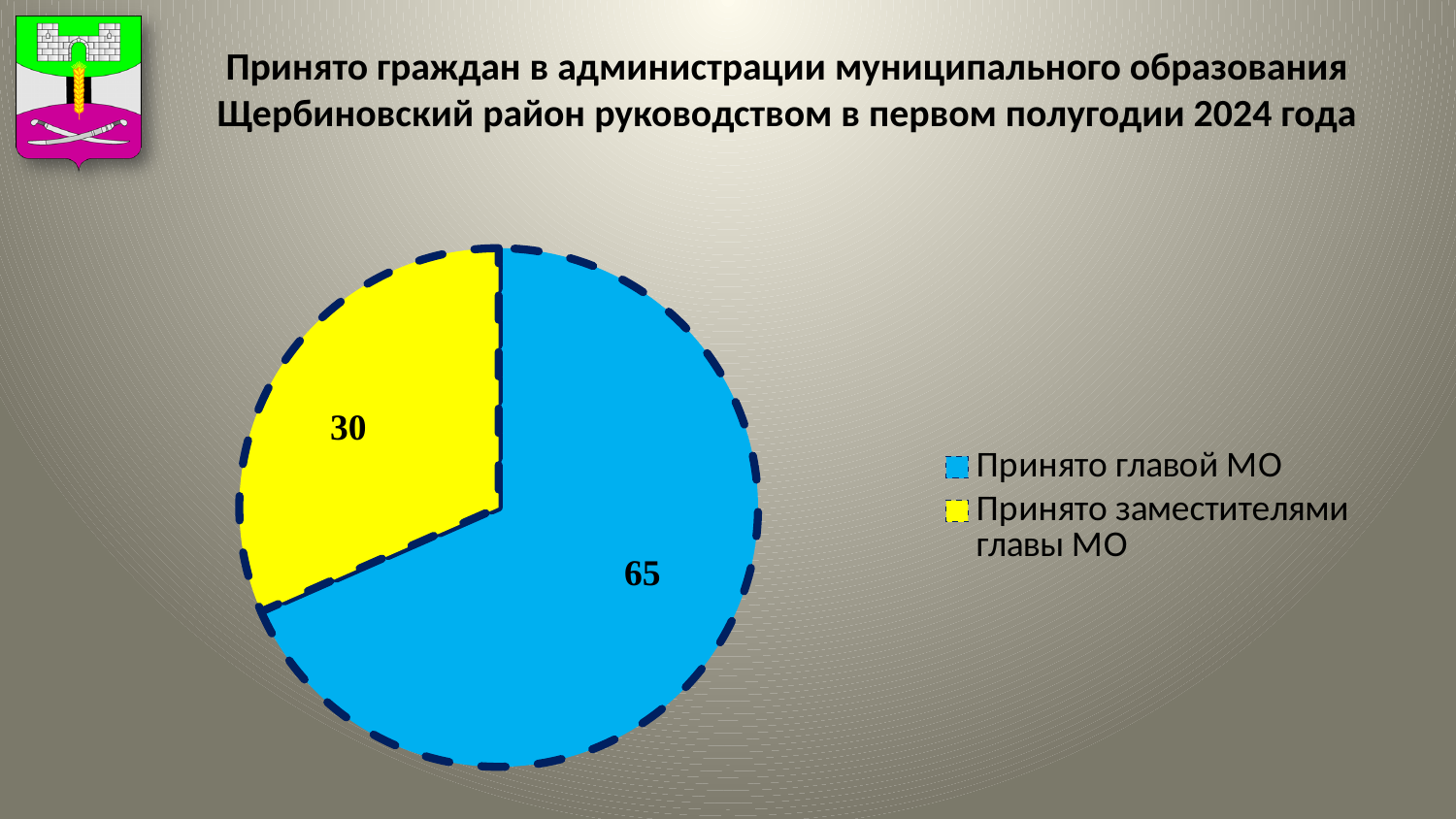
How many citizens were received by the head of the municipality (Принято главой МО) according to the pie chart? 65 What colour is the slice for 'Принято заместителями главы МО'? Yellow How many entries does the legend list? 2 What type of chart is shown on the slide? Pie chart Which is larger: the value for 'Принято главой МО' or the value for 'Принято заместителями главы МО'? Принято главой МО How many slices does the pie chart have? 2 What value is shown for the slice 'Принято заместителями главы МО'? 30 Which category has the smallest slice in the pie chart? Принято заместителями главы МО Which period does the chart title say the data covers? в первом полугодии 2024 года Which category has the largest slice in the pie chart? Принято главой МО What is the difference between the number received by the head of the municipality and the number received by the deputy heads? 35 What is the total number of citizens received, summing both slices of the pie chart? 95